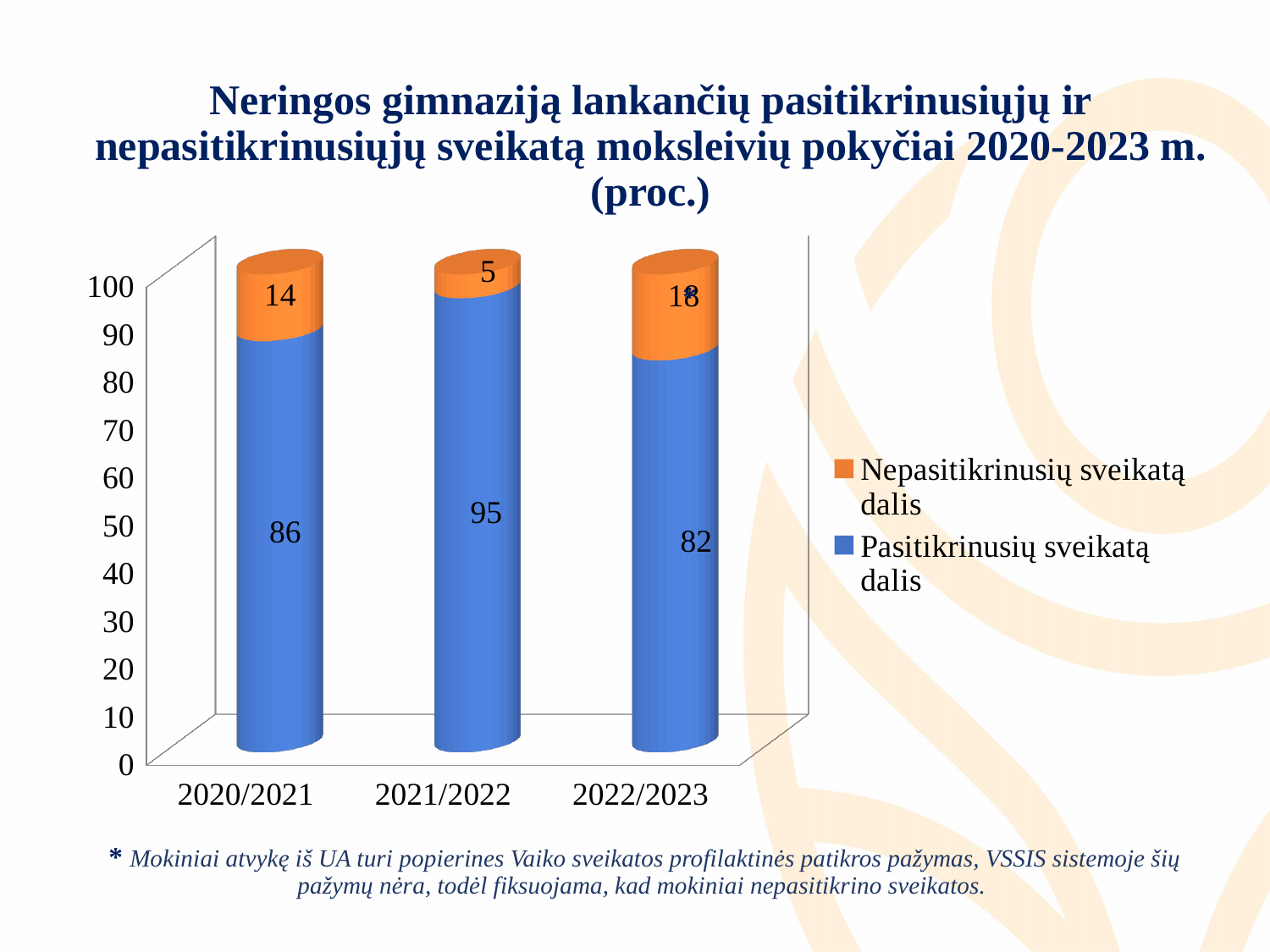
What is the total of the stacked bar for 2020/2021? 100 What is the value of "Nepasitikrinusių sveikatą dalis" for 2021/2022? 5 Which school year has the lowest value for "Nepasitikrinusių sveikatą dalis"? 2021/2022 Which is larger: the "Nepasitikrinusių sveikatą dalis" value for 2020/2021 or for 2022/2023? 2022/2023 What kind of chart is shown on the slide? Stacked bar chart Which school year has the highest value for "Pasitikrinusių sveikatą dalis"? 2021/2022 What is the value of "Pasitikrinusių sveikatą dalis" for 2022/2023? 82 How many series does the legend list? 2 How many school years are shown on the x axis? 3 What is the value of "Pasitikrinusių sveikatą dalis" for 2020/2021? 86 What is the difference between the "Pasitikrinusių sveikatą dalis" values for 2021/2022 and 2022/2023? 13 What is the value of "Nepasitikrinusių sveikatą dalis" for 2020/2021? 14